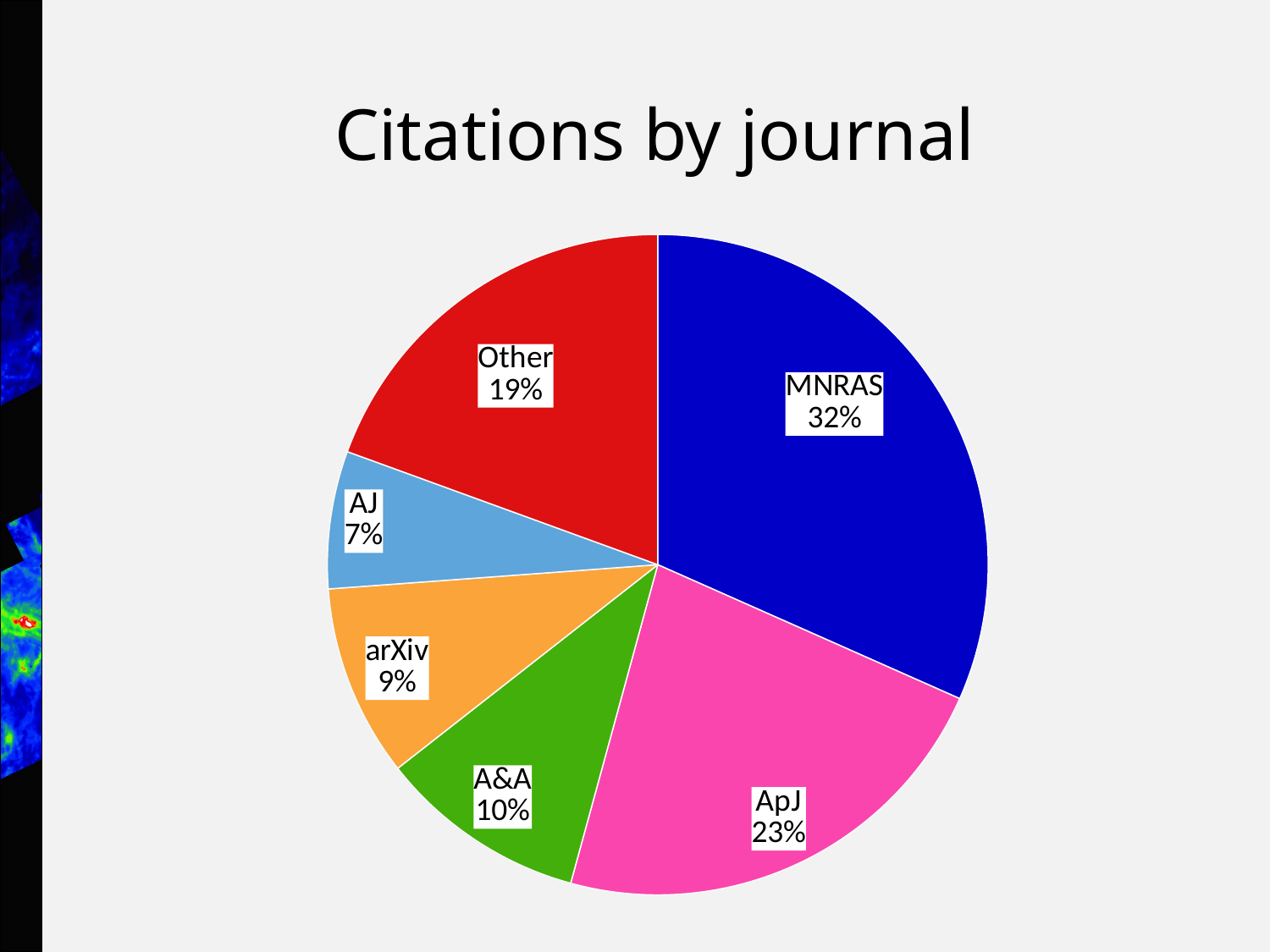
What is the title of the chart? Citations by journal What share of citations does ApJ account for? 23% What share of citations does MNRAS account for? 32% Which journal has the largest share of citations? MNRAS What percentage is shown for the arXiv slice? 9% What percentage is shown for the AJ slice? 7% What is the difference in percentage points between MNRAS and ApJ? 9 Which has a larger share, A&A or Other? Other What colour is the MNRAS slice? blue What type of chart is shown on the slide? pie chart Which category has the smallest share of citations? AJ How many slices does the pie chart have? 6